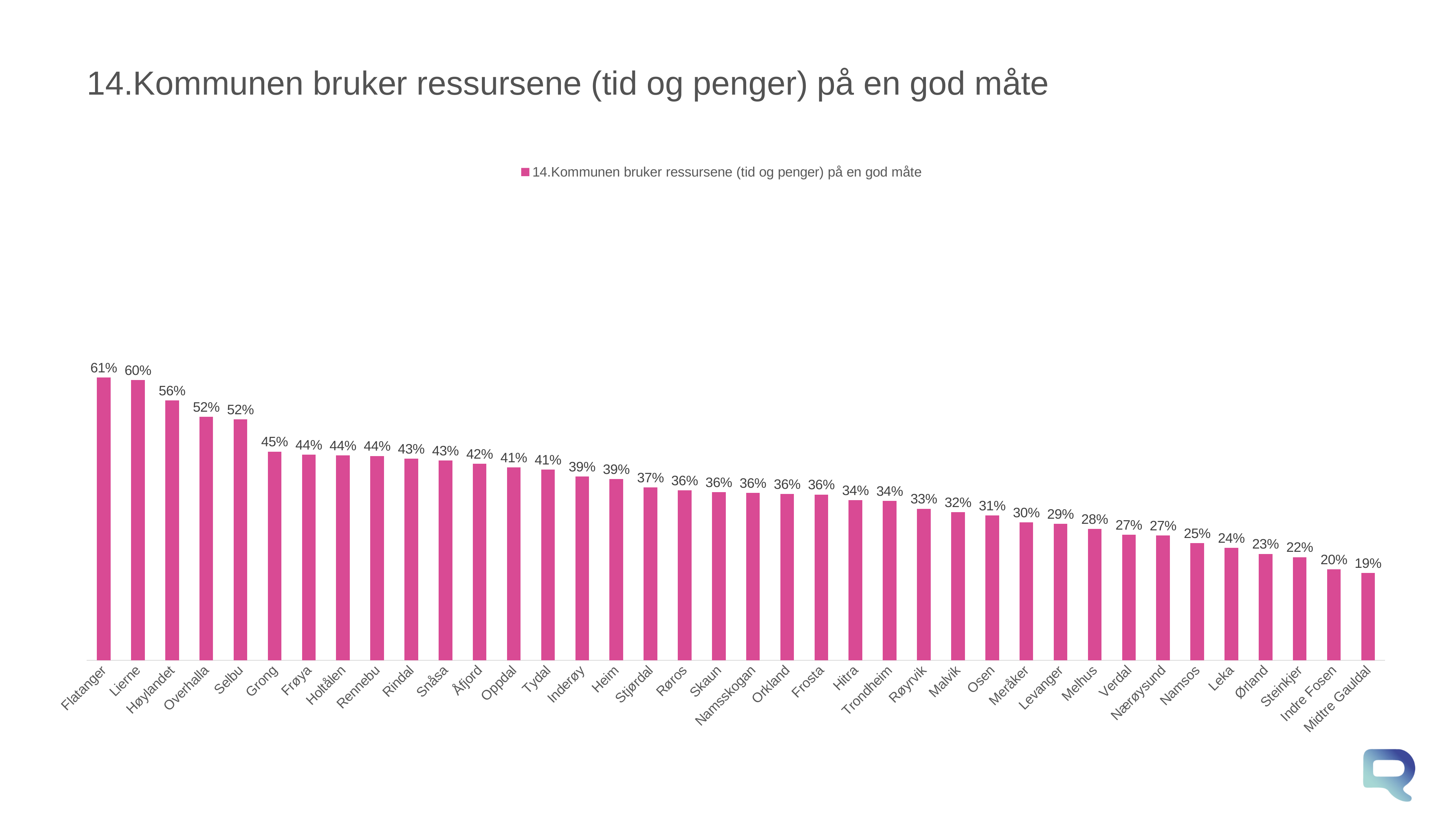
Which municipality has the highest value? Flatanger What kind of chart is shown on the slide? Bar chart What is the difference between the values for Høylandet and Stjørdal? 19% Which municipality has the lowest value? Midtre Gauldal Which has a larger value, Namsos or Åfjord? Åfjord How many municipalities are shown on the chart? 38 Which has a larger value, Malvik or Levanger? Malvik Do the values rise or fall from left to right along the x axis? Fall What is the value for Trondheim? 34% What is the value for Grong? 45% What is the value for Steinkjer? 22% What is the difference between the values for Flatanger and Midtre Gauldal? 42%